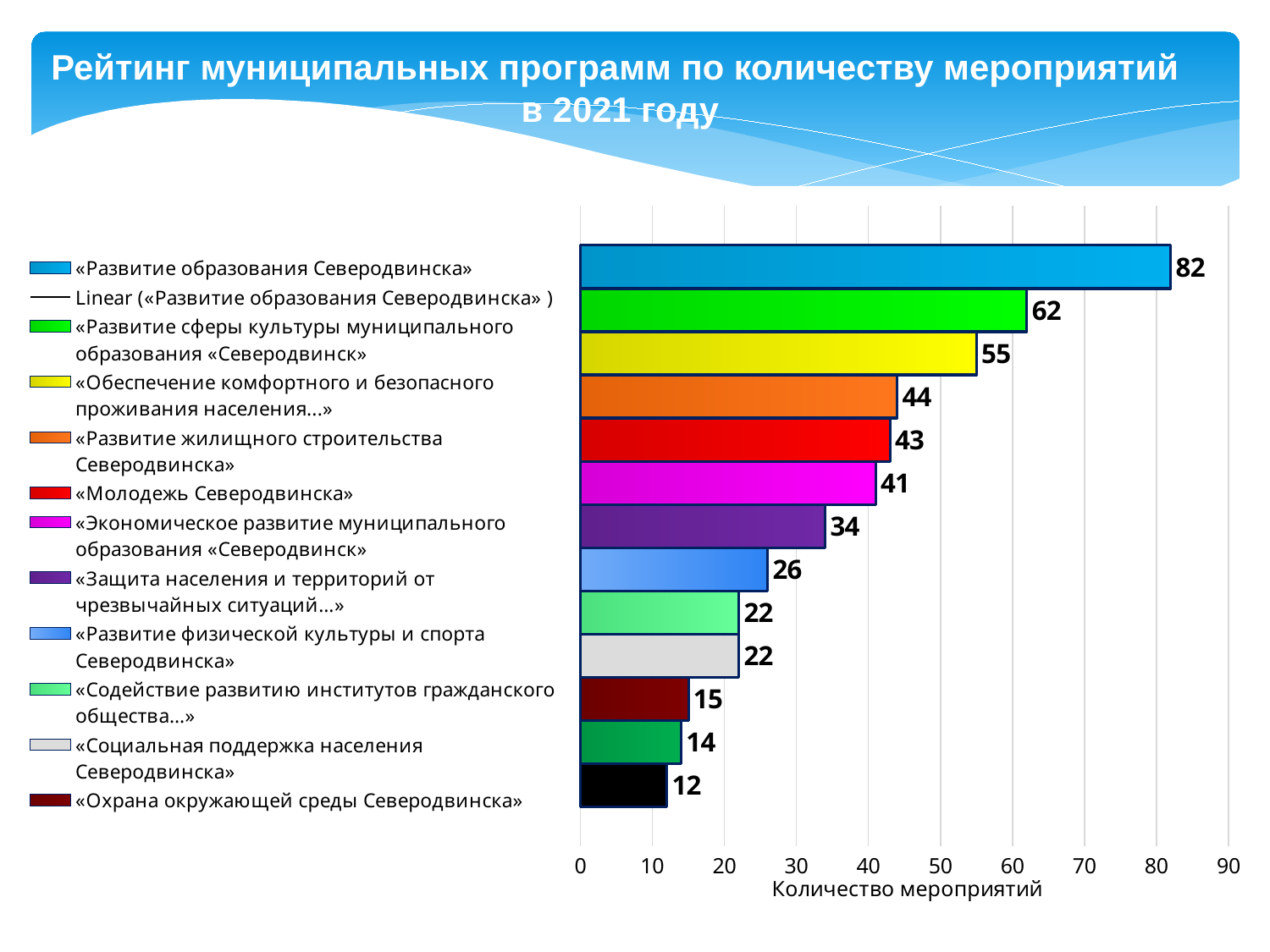
What kind of chart is shown on the slide? bar chart What is the label of the horizontal axis? Количество мероприятий Which program has the highest number of events? «Развитие образования Северодвинска» What is the value for «Молодежь Северодвинска»? 43 How many bars are plotted on the chart? 13 What is the difference between the values for «Развитие образования Северодвинска» and «Развитие сферы культуры муниципального образования «Северодвинск»? 20 What is the value for «Развитие физической культуры и спорта Северодвинска»? 26 Which is larger: the value for «Развитие жилищного строительства Северодвинска» or for «Молодежь Северодвинска»? «Развитие жилищного строительства Северодвинска» What is the smallest value shown on the chart? 12 What is the title of the slide? Рейтинг муниципальных программ по количеству мероприятий в 2021 году How many events does the program «Развитие образования Северодвинска» have? 82 What is the value for «Охрана окружающей среды Северодвинска»? 15